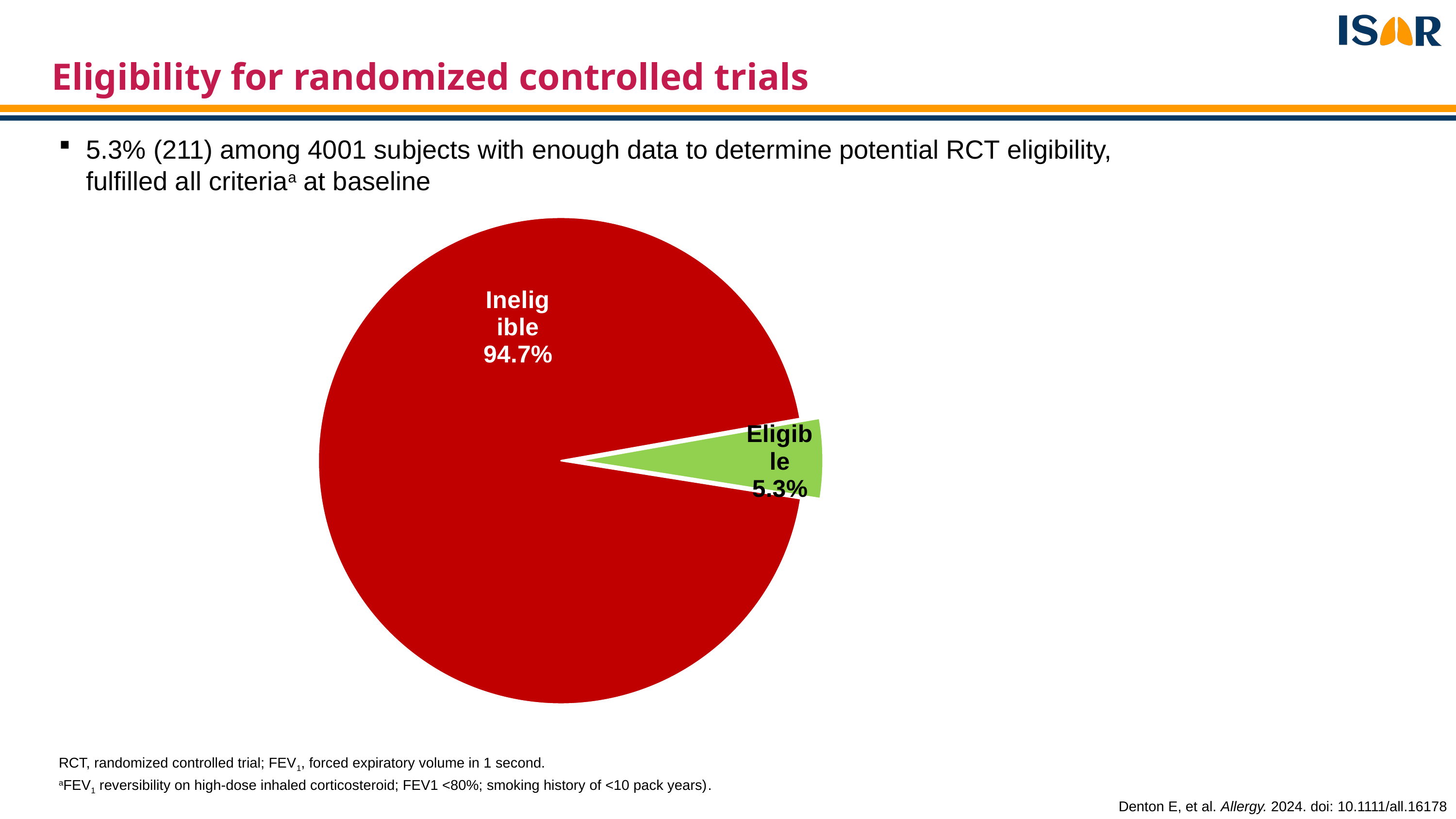
What percentage of subjects are shown as Ineligible in the pie chart? 94.7% What share of the pie does the Eligible slice represent? 5.3% What colour is the Ineligible slice in the pie chart? Red Which slice of the pie chart is the smallest? Eligible Which is larger, the Eligible slice or the Ineligible slice? Ineligible What kind of chart is shown on the slide? Pie chart What is the difference in percentage points between the Ineligible and Eligible slices? 89.4 What percentage of subjects are shown as Eligible in the pie chart? 5.3% Which slice of the pie chart is the largest? Ineligible What colour is the Eligible slice in the pie chart? Green How many slices does the pie chart have? 2